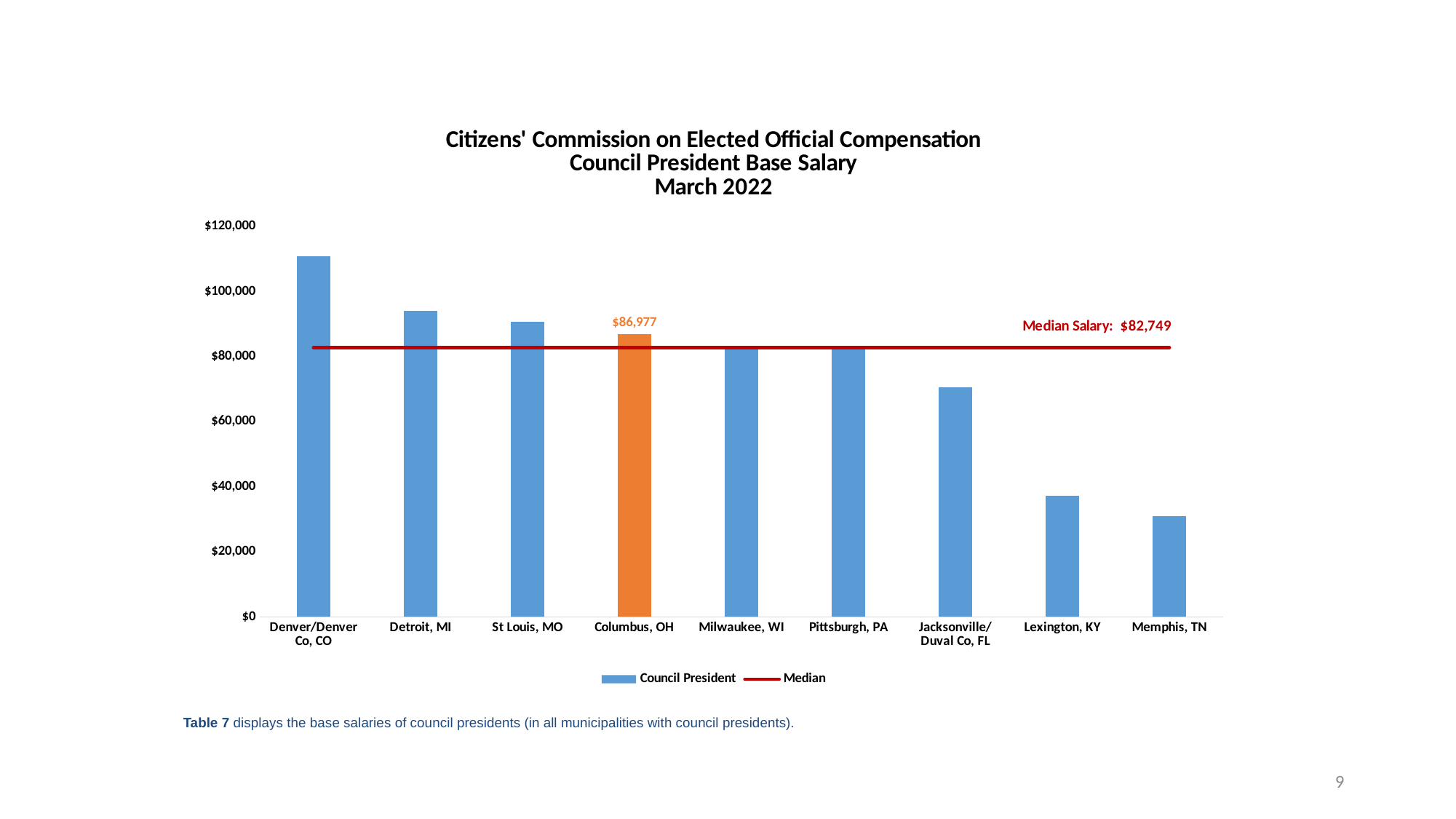
Is the value for Denver/Denver Co, CO greater or less than $100,000? greater What kind of chart is shown on the slide? Bar chart Do the Council President salaries rise or fall from left to right across the chart? Fall By how much does the Columbus, OH salary exceed the median salary? $4,228 What is the Council President base salary for Columbus, OH? $86,977 Is the value for Jacksonville/Duval Co, FL greater or less than $80,000? less What is the median salary shown on the chart? $82,749 How many entries does the legend list? 2 Which municipality has the highest Council President base salary? Denver/Denver Co, CO Which municipality has the lowest Council President base salary? Memphis, TN How many municipalities are shown on the chart? 9 Which has the larger Council President base salary, Detroit, MI or Lexington, KY? Detroit, MI